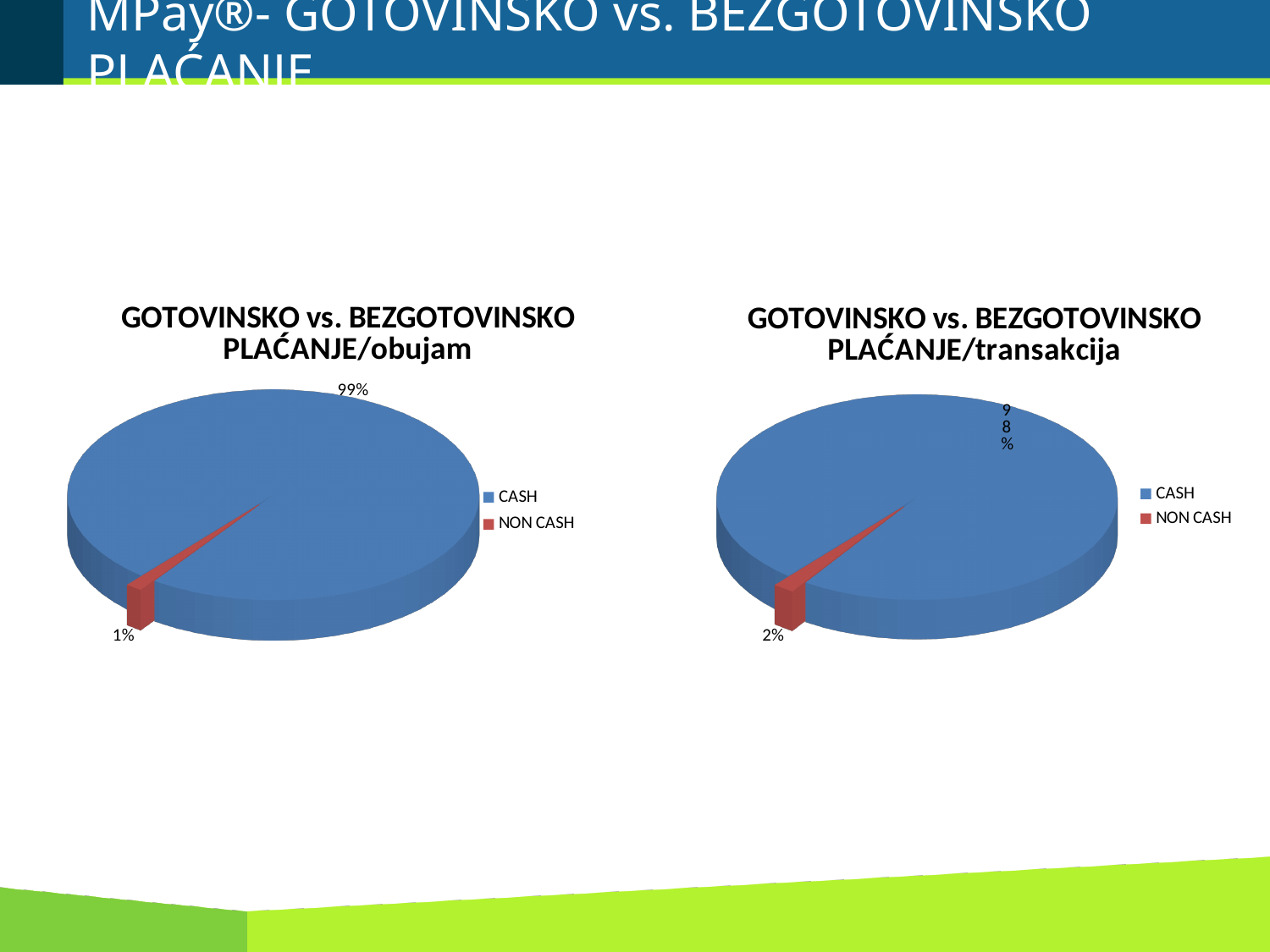
In the right chart (PLAĆANJE/transakcija), what is the difference between the CASH and NON CASH shares? 96% What type of chart is the left chart (PLAĆANJE/obujam)? pie chart In the left chart (PLAĆANJE/obujam), what share of the pie is CASH? 99% What is the title of the right chart? GOTOVINSKO vs. BEZGOTOVINSKO PLAĆANJE/transakcija In the right chart (PLAĆANJE/transakcija), which category has the smallest slice? NON CASH In the left chart (PLAĆANJE/obujam), what share of the pie is NON CASH? 1% Which chart shows a larger NON CASH share, the left (obujam) or the right (transakcija)? the right (transakcija) How many categories does the legend of the right chart (PLAĆANJE/transakcija) list? 2 In the right chart (PLAĆANJE/transakcija), what share of the pie is NON CASH? 2% In the left chart (PLAĆANJE/obujam), which category has the largest slice? CASH In the left chart (PLAĆANJE/obujam), what is the difference between the CASH and NON CASH shares? 98%